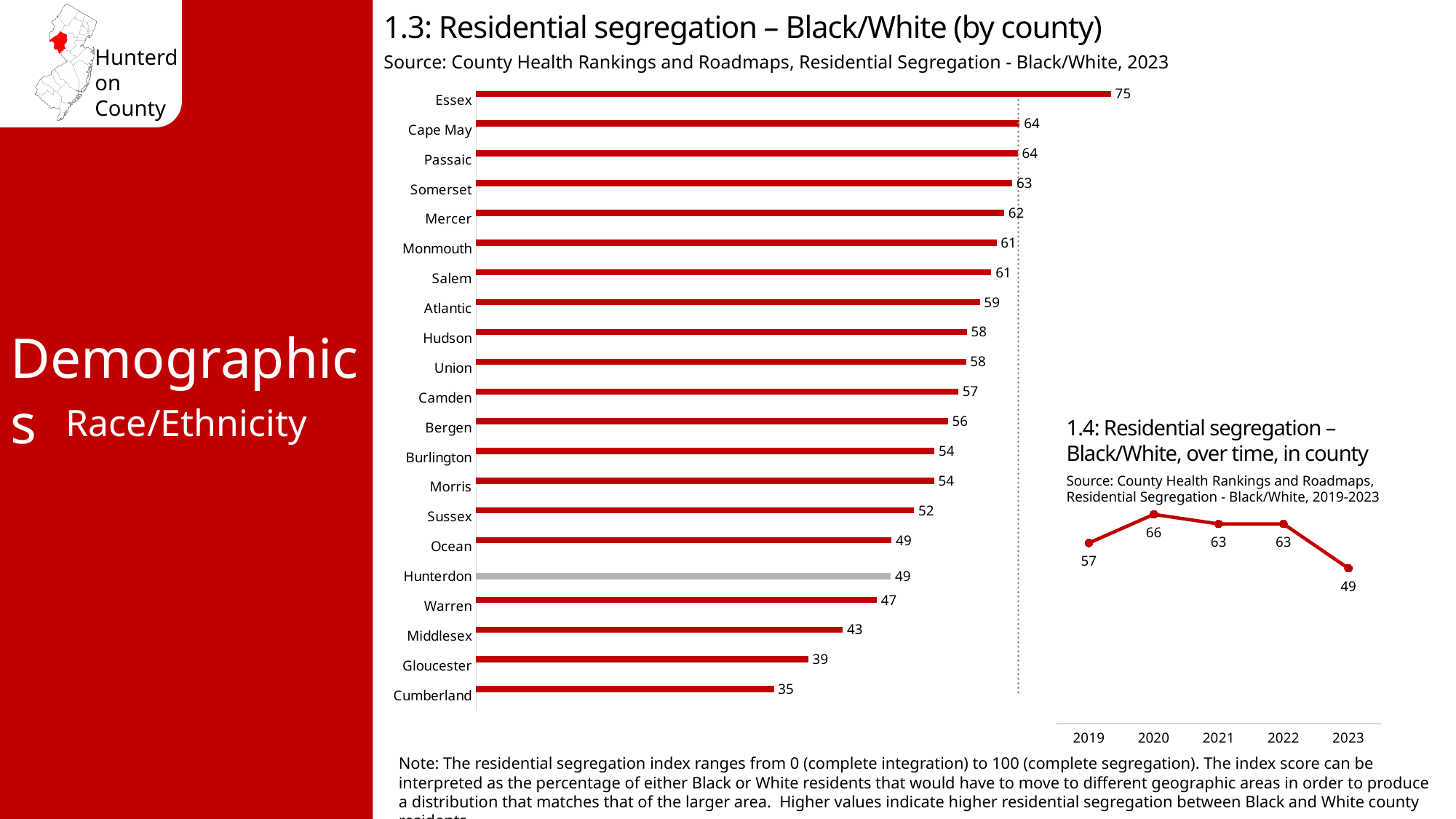
In the chart '1.3: Residential segregation – Black/White (by county)', what is the value for Hunterdon? 49 In the chart '1.4: Residential segregation – Black/White, over time, in county', what is the value for 2020? 66 In the chart '1.3: Residential segregation – Black/White (by county)', what is the value for Somerset? 63 In the chart '1.3: Residential segregation – Black/White (by county)', which county has the highest value? Essex In the chart '1.4: Residential segregation – Black/White, over time, in county', which year has the lowest value? 2023 What kind of chart is '1.4: Residential segregation – Black/White, over time, in county'? Line chart In the chart '1.3: Residential segregation – Black/White (by county)', what is the difference between the values for Essex and Cumberland? 40 In the chart '1.4: Residential segregation – Black/White, over time, in county', what is the difference between the values for 2022 and 2023? 14 In the chart '1.3: Residential segregation – Black/White (by county)', how many counties are shown? 21 What kind of chart is '1.3: Residential segregation – Black/White (by county)'? Bar chart In the chart '1.3: Residential segregation – Black/White (by county)', which is larger, the value for Middlesex or the value for Gloucester? Middlesex In the chart '1.3: Residential segregation – Black/White (by county)', which county has the lowest value? Cumberland